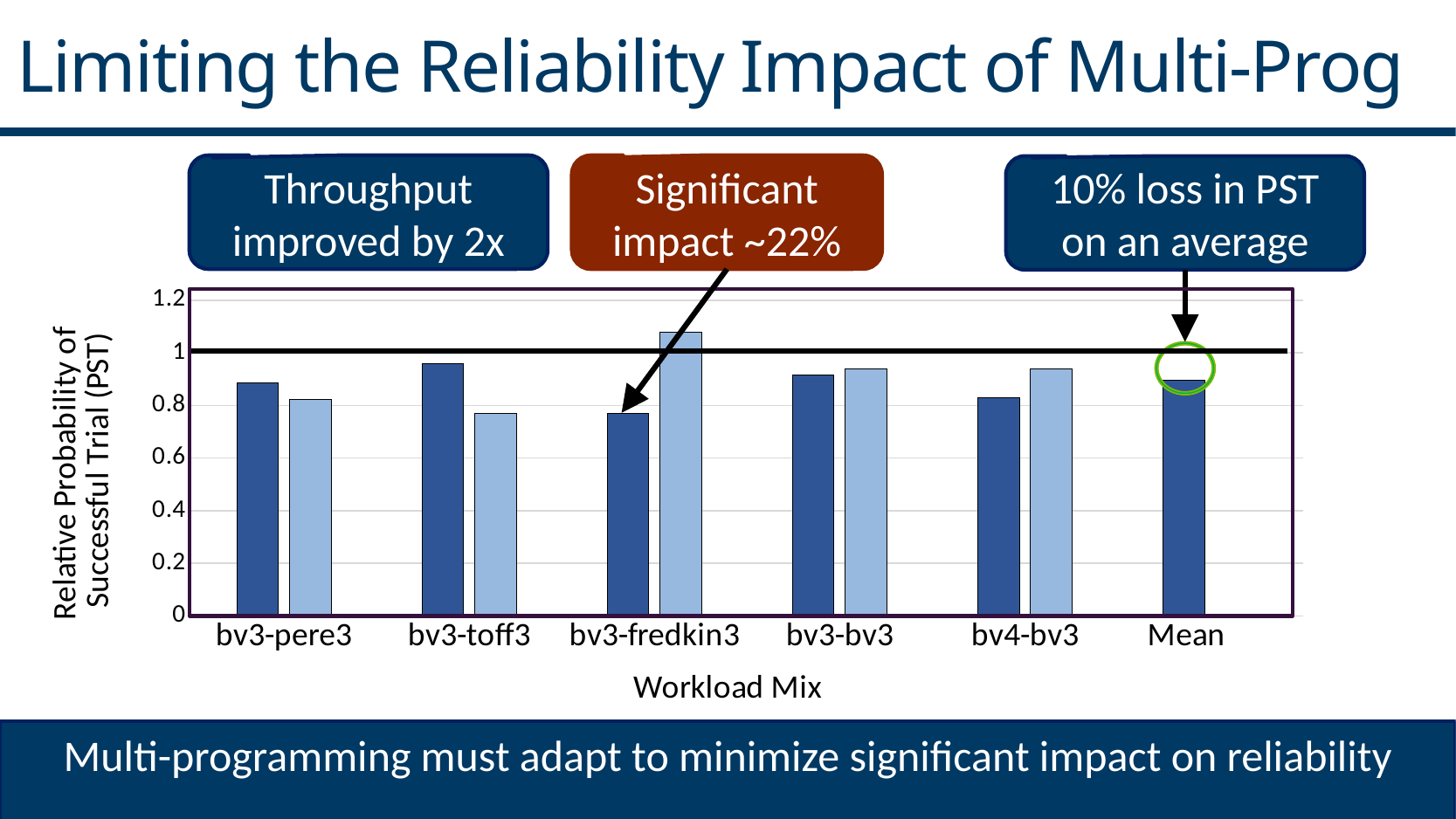
Is the Mean bar greater or less than 1? less Is the dark blue bar for bv3-bv3 greater or less than 0.8? greater What is the title of the x axis of the chart? Workload Mix How many bars are plotted for each workload mix other than Mean? 2 For bv3-toff3, which bar is taller, the dark blue bar or the light blue bar? dark blue bar What kind of chart is shown on the slide? bar chart What is the title of the y axis of the chart? Relative Probability of Successful Trial (PST) Which workload mix has the tallest bar in the chart? bv3-fredkin3 How many workload mix categories are shown on the x axis of the chart? 6 Is the dark blue bar for bv3-toff3 greater or less than 0.8? greater For bv3-fredkin3, which bar is taller, the dark blue bar or the light blue bar? light blue bar